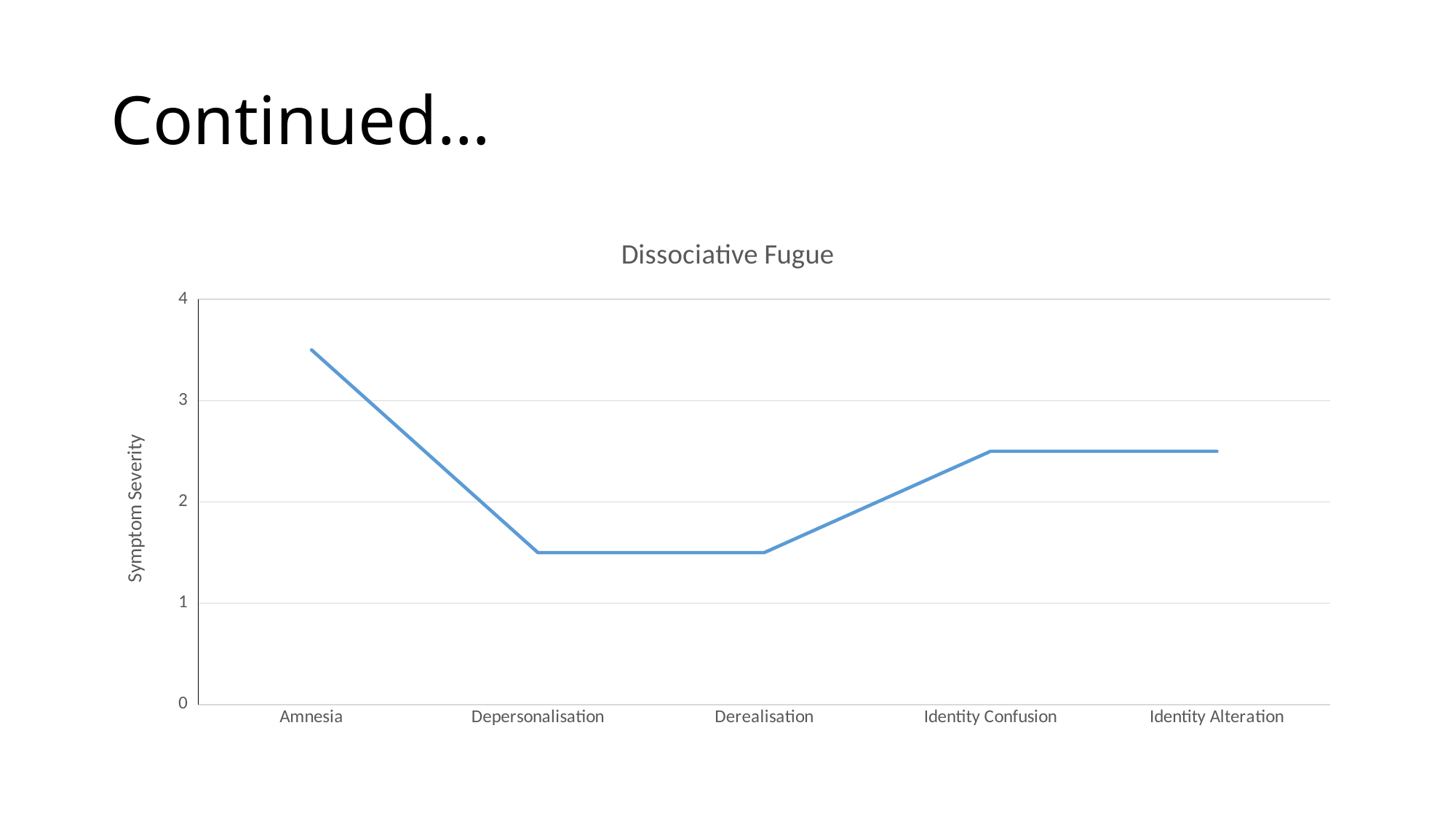
Which has the larger value, Amnesia or Identity Confusion? Amnesia Is the value for Identity Confusion greater or less than 3? less What is the title of the chart? Dissociative Fugue What is the label on the vertical axis of the chart? Symptom Severity Does the value rise or fall from Amnesia to Depersonalisation? fall Is the value for Depersonalisation greater or less than 2? less What type of chart is shown on the slide? line chart Which category has the highest symptom severity? Amnesia Is the value for Amnesia greater or less than 3? greater How many categories are plotted along the x axis? 5